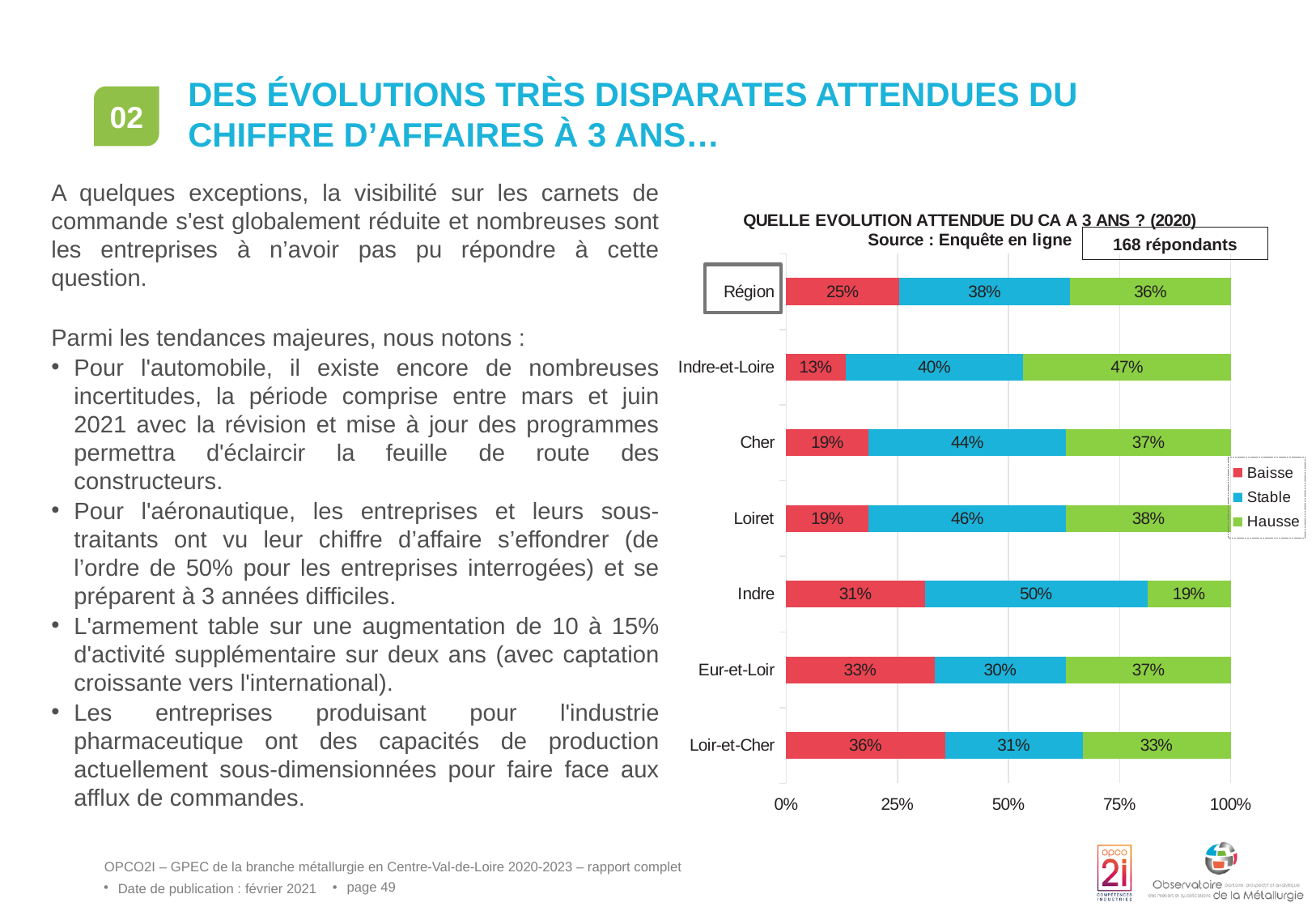
Which category has the highest Baisse value? Loir-et-Cher What is the Stable value for Indre? 50% Which category has the lowest Hausse value? Indre What is the Hausse value for Indre-et-Loire? 47% How many series does the legend list? 3 What is the Baisse value for Loir-et-Cher? 36% What is the total of the stacked bar for Région? 99% What is the difference between the Stable values for Indre and Eur-et-Loir? 20% How many respondents does the chart report? 168 répondants What kind of chart is shown on the slide? Stacked bar chart How many categories are shown on the y axis of the chart? 7 Which is larger, the Hausse value for Cher or the Hausse value for Loiret? Loiret